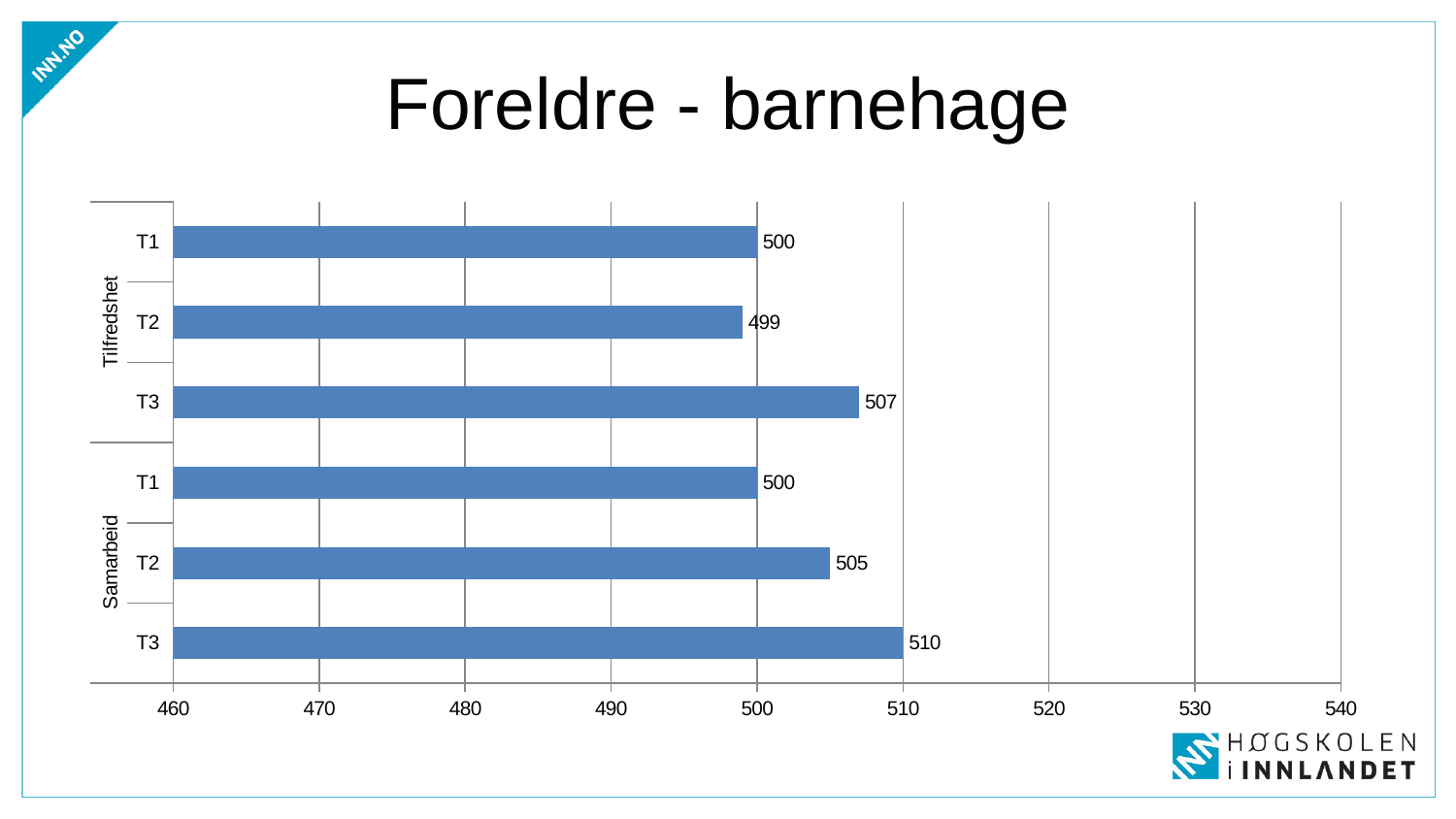
What is the title of the chart? Foreldre - barnehage Which bar has the lowest value on the chart? Tilfredshet T2 What is the value for T2 under Tilfredshet? 499 What is the value for T2 under Samarbeid? 505 Is the value for T3 under Tilfredshet greater or less than 510? less What is the value for T3 under Tilfredshet? 507 How many bars are plotted on the chart? 6 Which bar has the highest value on the chart? Samarbeid T3 What kind of chart is shown on the slide? bar chart What is the difference between T1 and T3 under Samarbeid? 10 Which is larger, T2 under Tilfredshet or T2 under Samarbeid? T2 under Samarbeid What is the difference between the T3 values for Samarbeid and Tilfredshet? 3